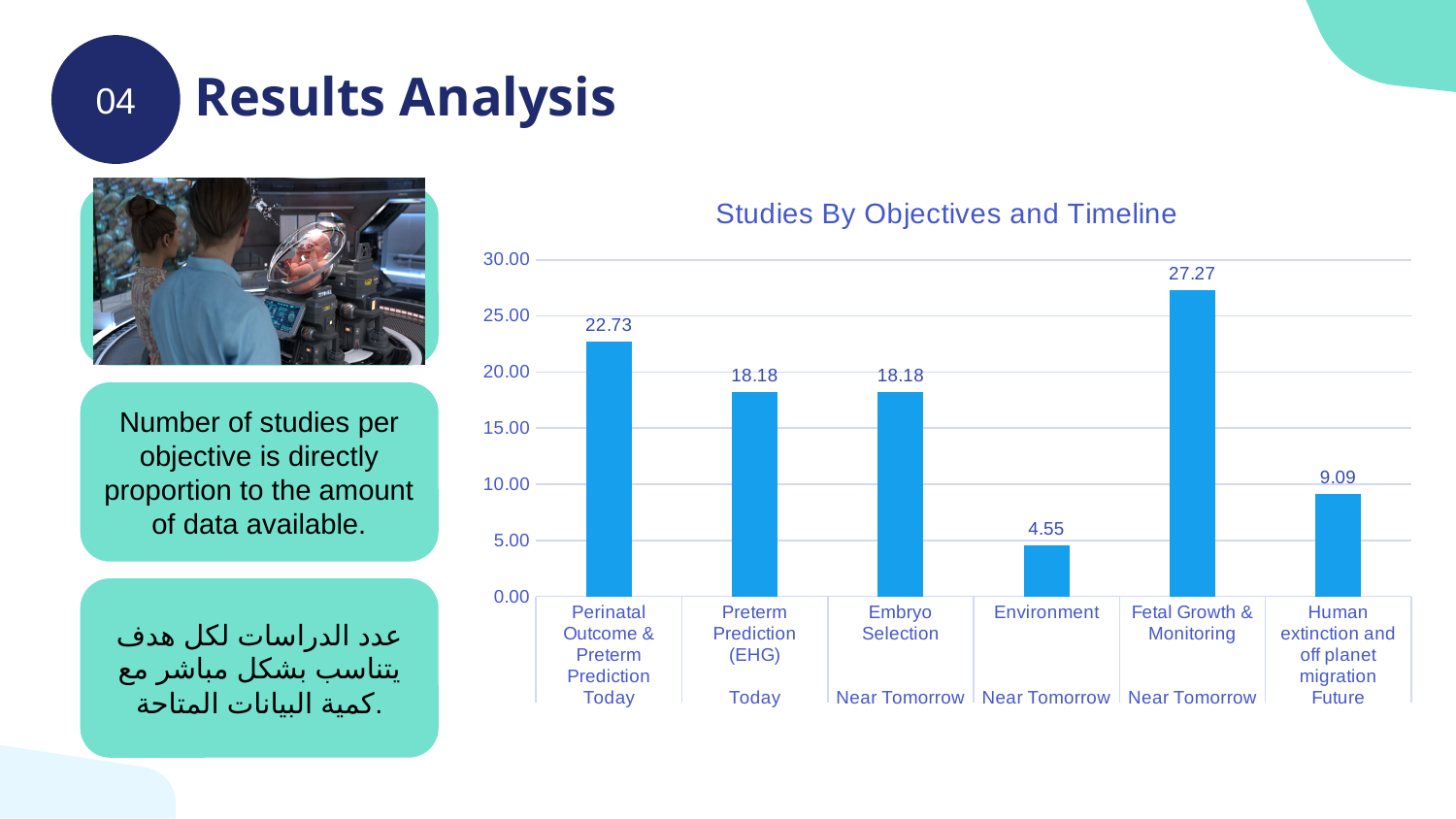
What is the difference between the values for Fetal Growth & Monitoring and Perinatal Outcome & Preterm Prediction? 4.54 What is the title of the chart? Studies By Objectives and Timeline Which category has the highest value? Fetal Growth & Monitoring What kind of chart is shown on the slide? bar chart Is the value for Preterm Prediction (EHG) greater or less than 20.00? less Which category has the lowest value? Environment Which is larger, the value for Embryo Selection or the value for Human extinction and off planet migration? Embryo Selection How many categories are shown on the x axis? 6 What is the value for Human extinction and off planet migration? 9.09 What is the value for Perinatal Outcome & Preterm Prediction? 22.73 What is the value for Environment? 4.55 What is the value for Fetal Growth & Monitoring? 27.27